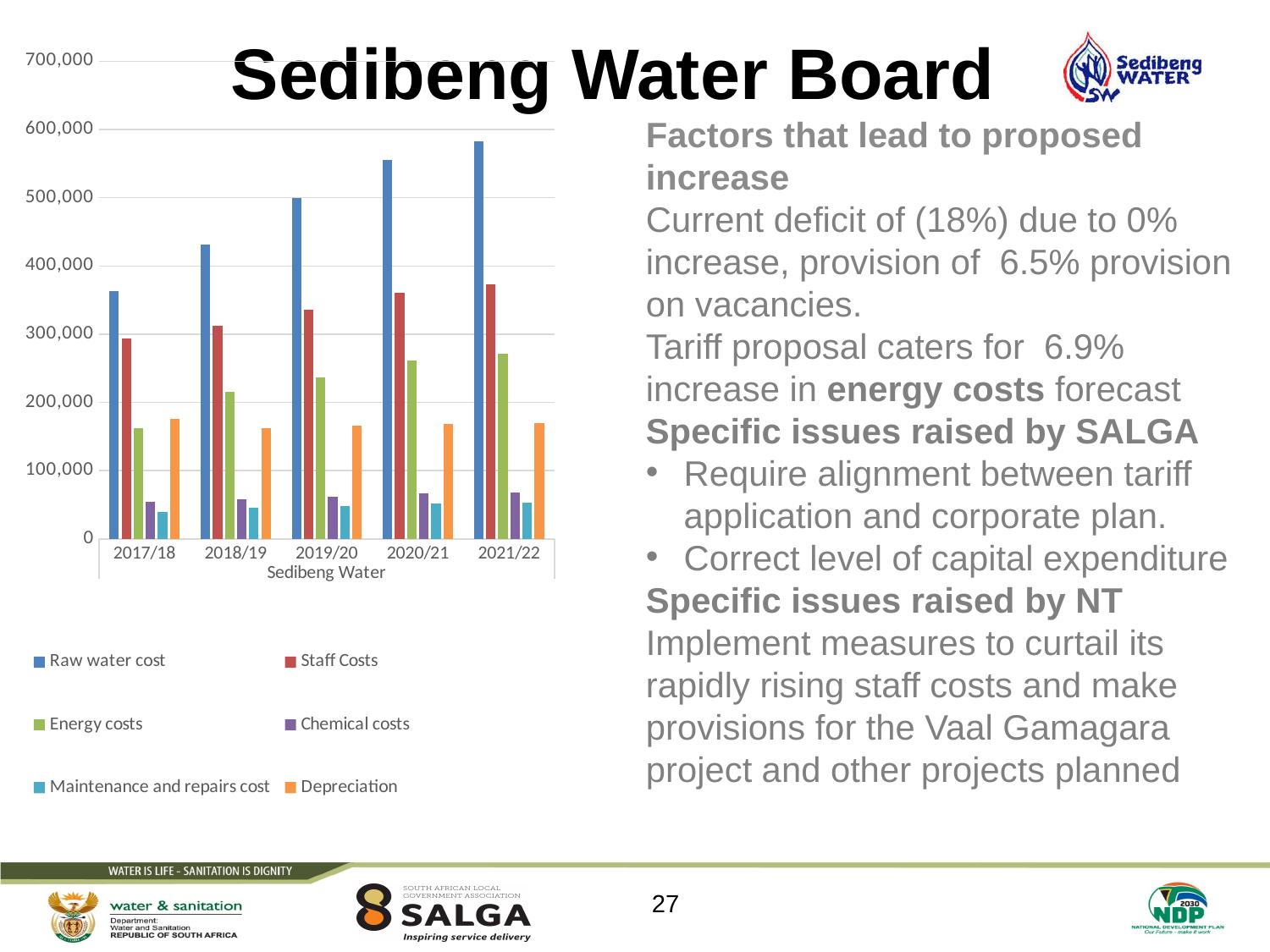
In 2020/21, which is larger: Raw water cost or Staff Costs? Raw water cost Is the Raw water cost value for 2017/18 greater or less than 300,000? greater Is the Staff Costs value for 2021/22 greater or less than 400,000? less Is the Raw water cost value for 2021/22 greater or less than 500,000? greater What kind of chart is shown on the slide? bar chart How many financial years are shown on the x axis of the chart? 5 Do the Raw water cost values rise or fall from 2017/18 to 2021/22? rise In which year is the Raw water cost highest? 2021/22 Which series has the highest value in 2017/18? Raw water cost How many series does the chart's legend list? 6